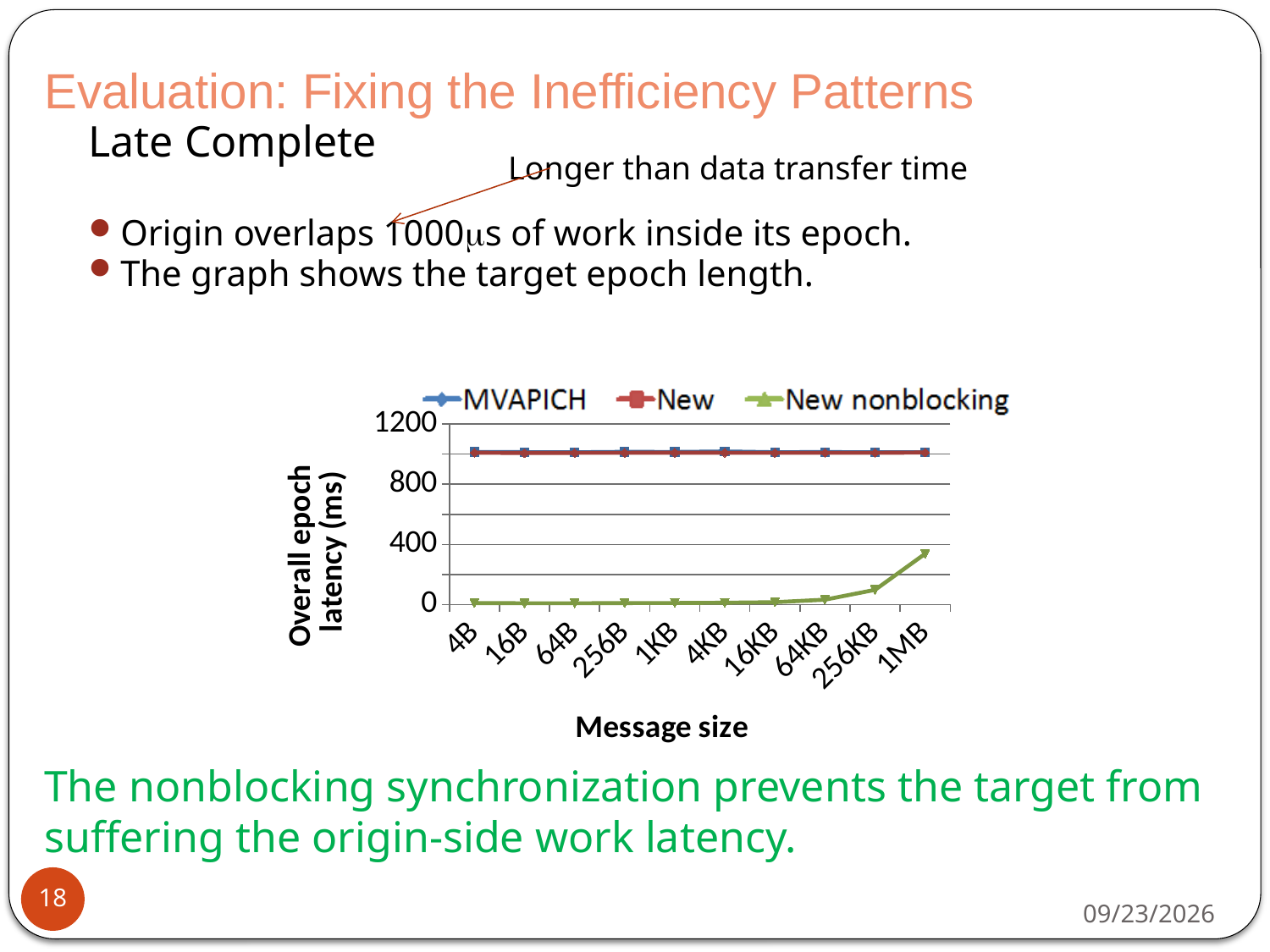
How many series does the chart's legend list? 3 What kind of chart is shown on the slide? line chart Is the value for New at 1MB greater or less than 800? greater Is the value for MVAPICH at 4B greater or less than 800? greater Which is larger at 1MB, the value for MVAPICH or the value for New nonblocking? MVAPICH Does the New nonblocking series rise or fall as message size increases from 64KB to 1MB? rise Is the value for New nonblocking at 1MB greater or less than 400? less What is the label of the chart's x axis? Message size Which series has the lowest value at 256KB? New nonblocking What is the label of the chart's y axis? Overall epoch latency (ms) How many message sizes are plotted along the x axis of the chart? 10